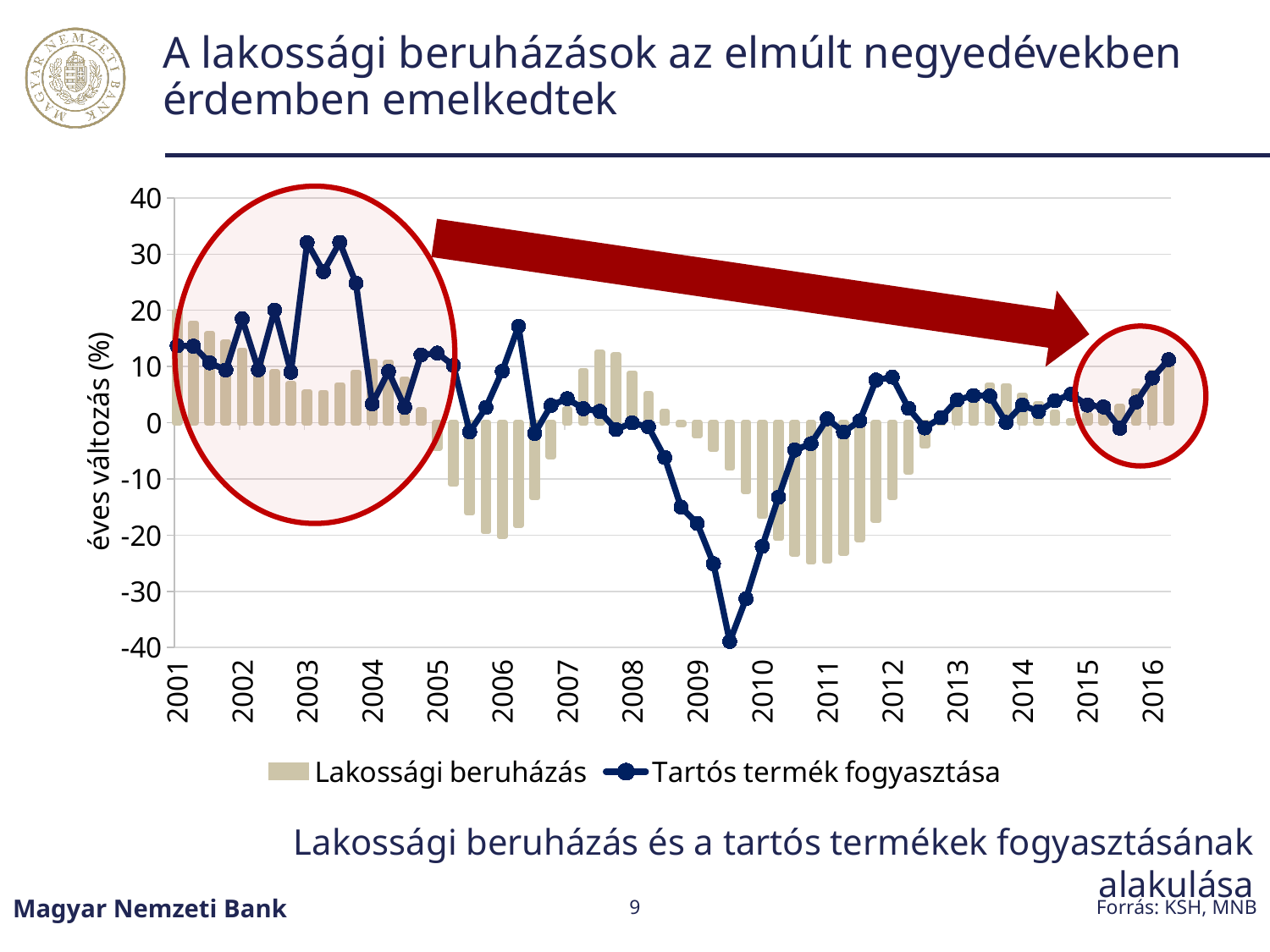
Is the peak value of the Tartós termék fogyasztása line in 2003 greater or less than 20? greater What kind of chart is shown on the slide? A combined bar and line chart What is the label of the vertical axis? éves változás (%) In which year does the Tartós termék fogyasztása line reach its lowest point? 2009 Which series is drawn as bars in the chart? Lakossági beruházás Is the peak value of the Tartós termék fogyasztása line in 2006 greater or less than 10? greater How many series does the legend list? 2 Which is larger: the peak of the Tartós termék fogyasztása line in 2003 or its peak in 2006? 2003 In which year does the Tartós termék fogyasztása line reach its highest values? 2003 Is the lowest value of the Tartós termék fogyasztása line in 2009 greater or less than -30? less How many years are labelled on the horizontal axis? 16 Does the Tartós termék fogyasztása line rise or fall between 2015 and 2016? rise